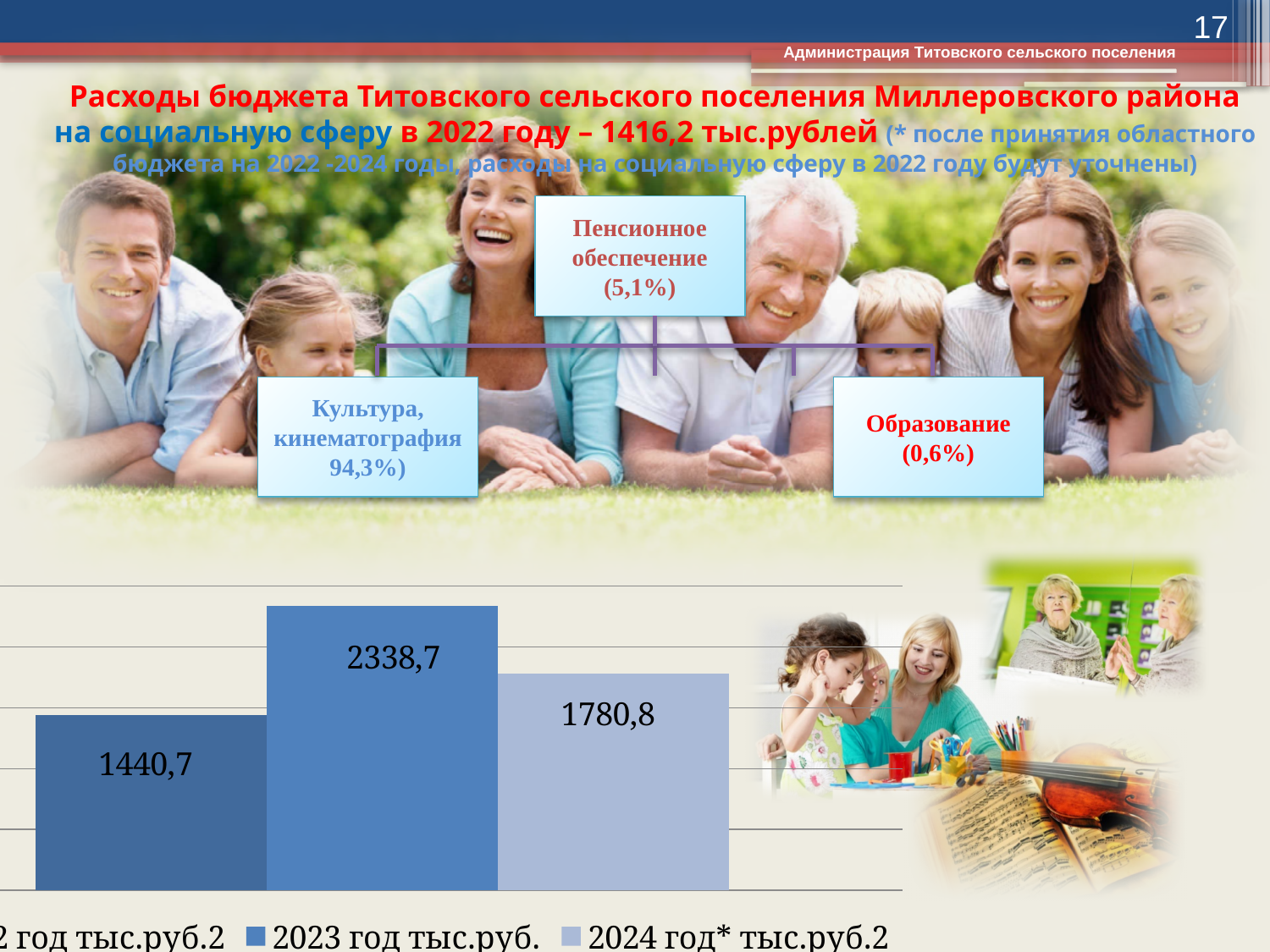
In the bar chart, how much larger is the 2023 год тыс.руб. value than the leftmost bar's value of 1440,7? 898,0 In the bar chart, what is the difference between the 2024 год* тыс.руб. value and the leftmost bar's value of 1440,7? 340,1 In the bar chart, what value is printed on the leftmost (dark blue) bar? 1440,7 In the bar chart, which is larger: the value for 2023 год тыс.руб. or the value for 2024 год* тыс.руб.? 2023 год тыс.руб. In the bar chart, what is the difference between the 2023 год тыс.руб. value and the 2024 год* тыс.руб. value? 557,9 In the bar chart, what is the value for the series "2024 год* тыс.руб."? 1780,8 In the bar chart, which bar has the lowest value? the leftmost (dark blue) bar, 1440,7 How many bars are plotted in the bar chart? 3 In the bar chart, which series has the highest value? 2023 год тыс.руб. In the bar chart, what is the value for the series "2023 год тыс.руб."? 2338,7 What kind of chart is shown at the bottom of the slide? bar chart How many series does the legend of the bar chart list? 3